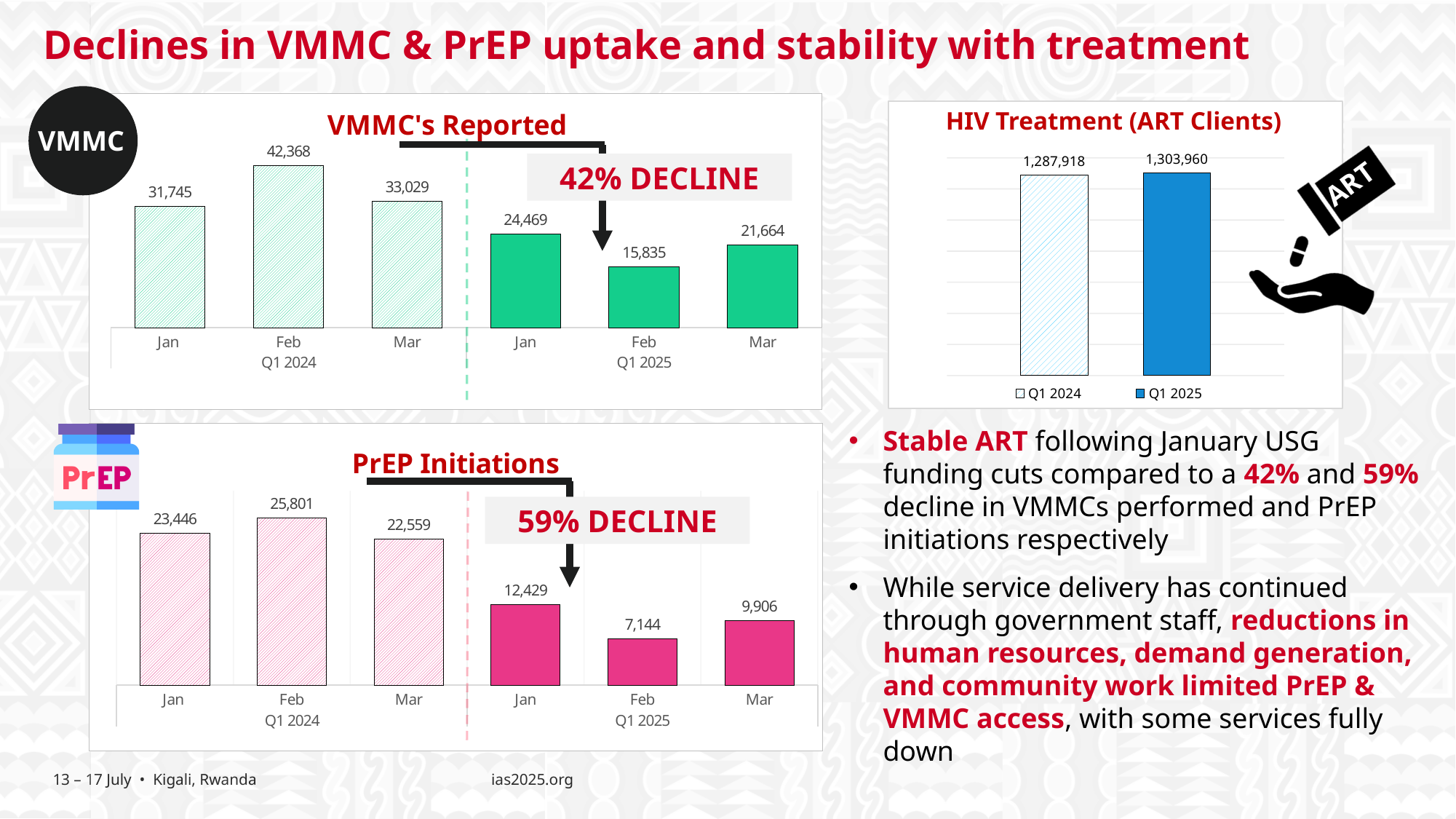
In the HIV Treatment (ART Clients) chart, what is the difference between Q1 2025 and Q1 2024? 16,042 In the HIV Treatment (ART Clients) chart, what value is shown for Q1 2025? 1,303,960 In the PrEP Initiations chart, which is larger, Mar Q1 2024 or Mar Q1 2025? Mar Q1 2024 In the VMMC's Reported chart, what value is shown for Feb Q1 2024? 42,368 In the PrEP Initiations chart, which month has the highest value? Feb Q1 2024 In the VMMC's Reported chart, how many bars are plotted? 6 In the PrEP Initiations chart, what value is shown for Feb Q1 2025? 7,144 In the PrEP Initiations chart, what is the difference between Jan Q1 2025 and Feb Q1 2025? 5,285 In the HIV Treatment (ART Clients) chart, how many entries does the legend list? 2 What type of chart is the HIV Treatment (ART Clients) chart? Bar chart In the VMMC's Reported chart, which month has the lowest value? Feb Q1 2025 In the VMMC's Reported chart, what is the difference between Jan Q1 2024 and Jan Q1 2025? 7,276